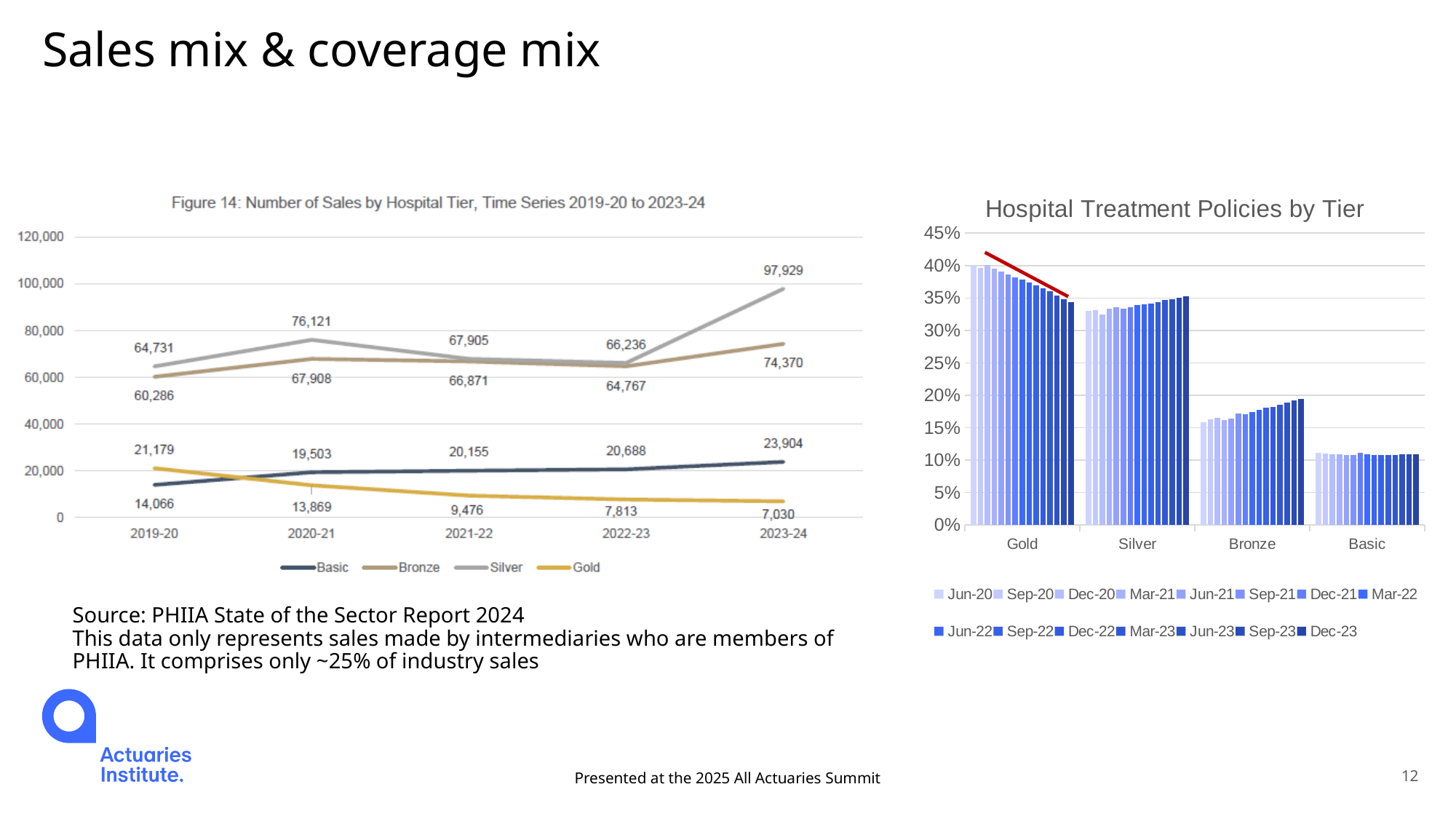
In the Figure 14 line chart, which had more sales in 2020-21, Silver or Bronze? Silver How many series does the legend of the Figure 14 line chart list? 4 What kind of chart is the 'Hospital Treatment Policies by Tier' chart? bar chart In the Figure 14 line chart, what was the number of Silver sales in 2023-24? 97,929 In the Figure 14 line chart, in which year were Silver sales highest? 2023-24 In the Figure 14 line chart, what was the number of Basic sales in 2020-21? 19,503 In the Figure 14 line chart, by how much did Basic sales increase from 2019-20 to 2023-24? 9,838 In the Figure 14 line chart, what was the number of Gold sales in 2021-22? 9,476 In the Figure 14 line chart, what is the difference between Silver and Bronze sales in 2023-24? 23,559 In the Figure 14 line chart, does the Gold series rise or fall from 2019-20 to 2023-24? fall In the Figure 14 line chart, in which year were Gold sales lowest? 2023-24 In the 'Hospital Treatment Policies by Tier' chart, is the Jun-20 value for Gold greater or less than 35%? greater